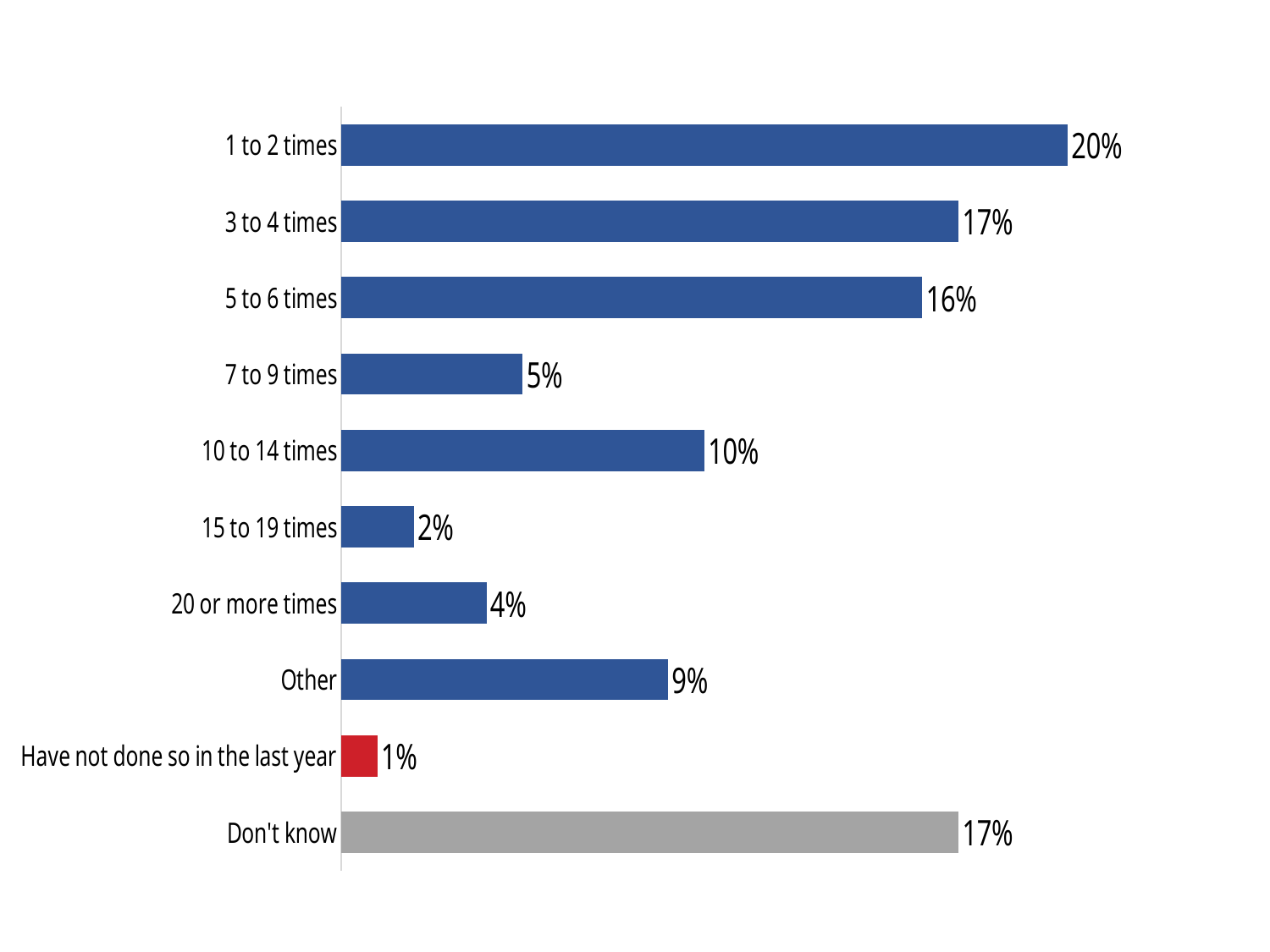
What is the value for "10 to 14 times"? 10% What colour is the bar for "Have not done so in the last year"? Red What kind of chart is this? Bar chart How many categories are shown in the chart? 10 What is the value for "1 to 2 times"? 20% What is the difference between the values for "3 to 4 times" and "7 to 9 times"? 12% What is the value for "Have not done so in the last year"? 1% Which category has the lowest value? Have not done so in the last year Which is larger, the value for "Other" or the value for "20 or more times"? Other What is the value for "Don't know"? 17% What colour is the bar for "Don't know"? Grey Which category has the highest value? 1 to 2 times